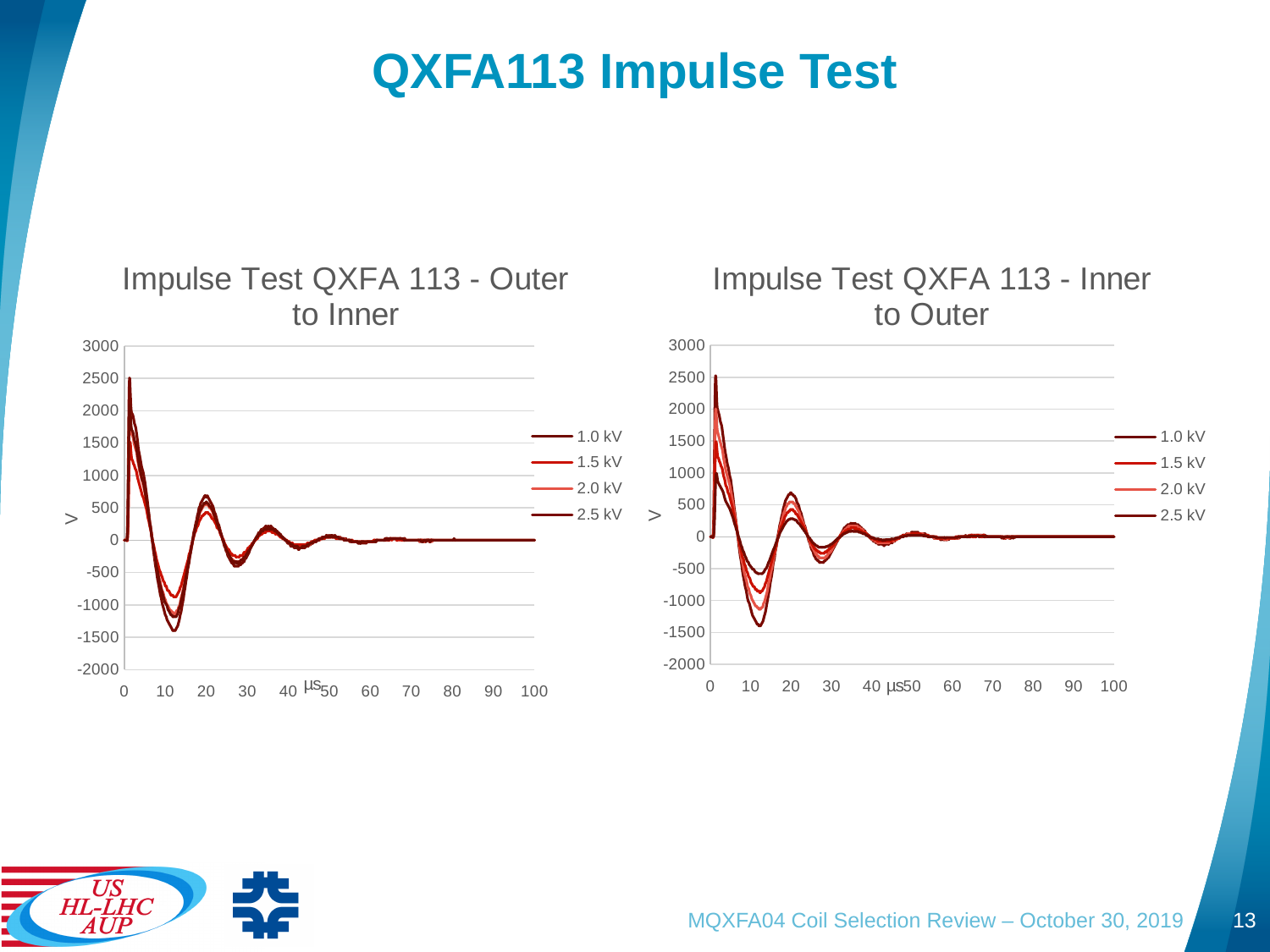
In the left chart, 'Impulse Test QXFA 113 - Outer to Inner', is the highest value reached by any line greater or less than 2000? greater In the left chart, 'Impulse Test QXFA 113 - Outer to Inner', do the oscillations grow or decay as the x axis increases? decay In the left chart, 'Impulse Test QXFA 113 - Outer to Inner', what are the legend entries? 1.0 kV, 1.5 kV, 2.0 kV, 2.5 kV In the right chart, 'Impulse Test QXFA 113 - Inner to Outer', is the lowest value reached by any line greater or less than -1000? less How many series does the legend of the right chart, 'Impulse Test QXFA 113 - Inner to Outer', list? 4 What kind of chart is the right chart, 'Impulse Test QXFA 113 - Inner to Outer'? Line chart In the right chart, 'Impulse Test QXFA 113 - Inner to Outer', do the oscillations grow or decay as the x axis increases? decay What is the y-axis label of the right chart, 'Impulse Test QXFA 113 - Inner to Outer'? V In the left chart, 'Impulse Test QXFA 113 - Outer to Inner', is the lowest value reached by any line greater or less than -1000? less How many series does the legend of the left chart, 'Impulse Test QXFA 113 - Outer to Inner', list? 4 What kind of chart is the left chart, 'Impulse Test QXFA 113 - Outer to Inner'? Line chart